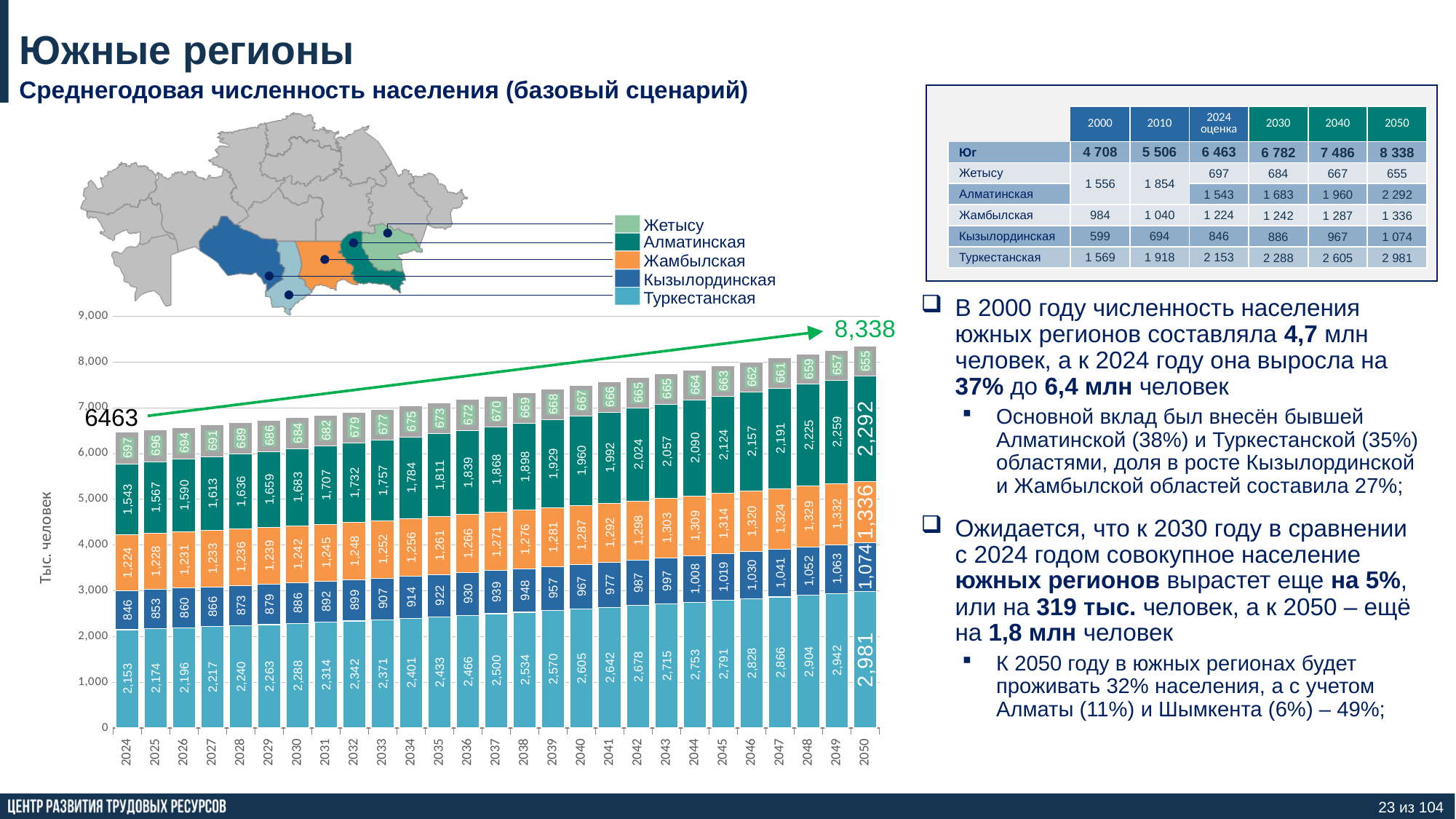
Do the values for Жетысу rise or fall from 2024 to 2050? Fall What unit is shown on the y axis of the chart? Тыс. человек What kind of chart is shown on the slide? Stacked bar chart What is the total of the stacked bar for 2050, as annotated on the chart? 8,338 What is the value for Алматинская in 2024 on the chart? 1,543 By how much does the value for Туркестанская in 2050 exceed its value in 2024? 828 What is the value for Туркестанская in 2050 on the chart? 2,981 What is the value for Кызылординская in 2030 on the chart? 886 How many series does the chart legend list? 5 In 2040, which is larger: the value for Алматинская or for Жамбылская? Алматинская What is the total of the stacked bar for 2024, as annotated on the chart? 6463 How many years (bars) are plotted along the x axis of the chart? 27